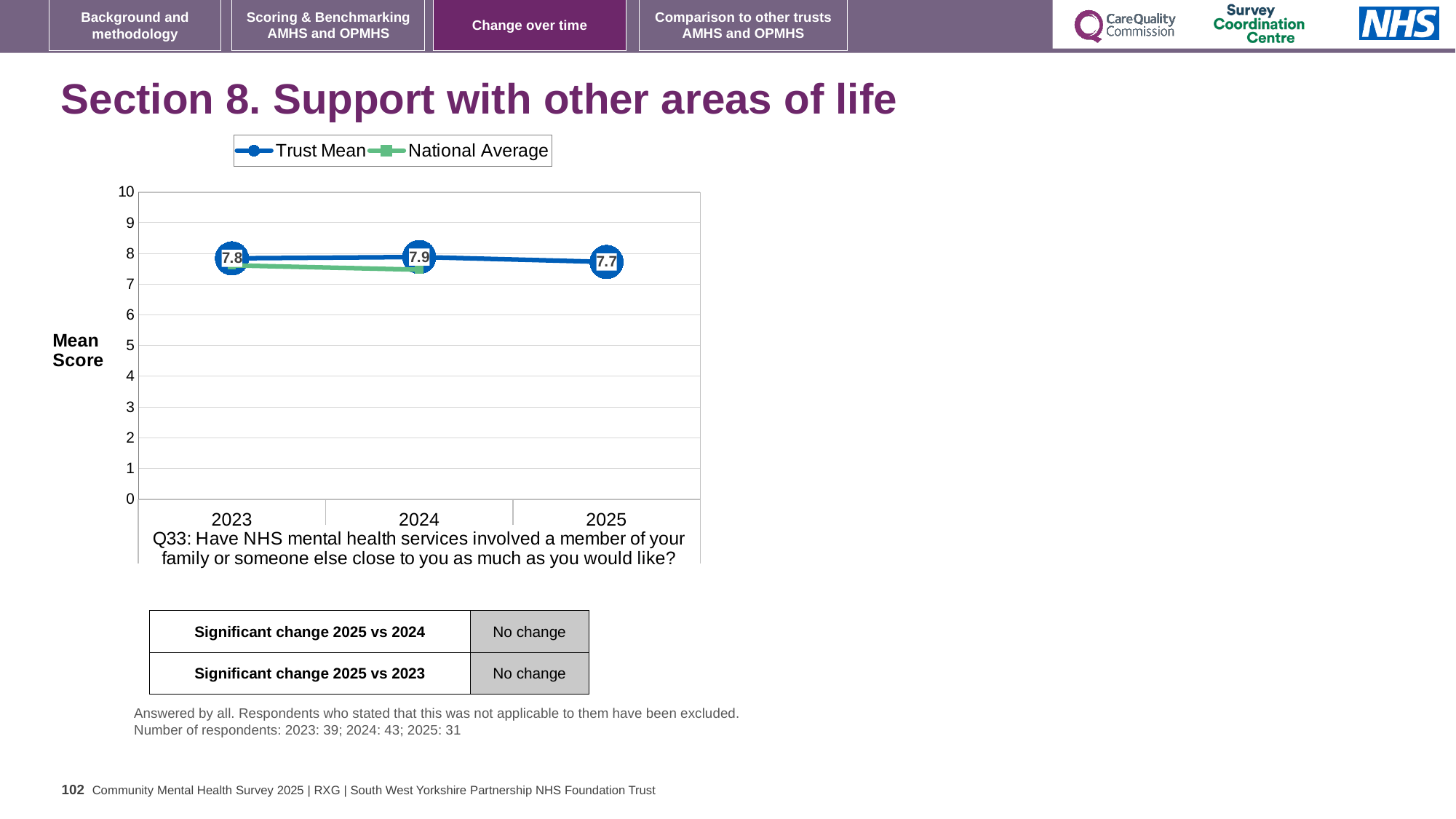
In which year is the Trust Mean lowest? 2025 What is the Trust Mean value for 2025? 7.7 What is the label of the y axis of the chart? Mean Score In which year is the Trust Mean highest? 2024 What is the difference between the Trust Mean in 2024 and in 2025? 0.2 Which is larger, the Trust Mean for 2023 or for 2025? 2023 What is the Trust Mean value for 2023? 7.8 What is the Trust Mean value for 2024? 7.9 Is the Trust Mean for 2025 greater or less than 5? greater What kind of chart is shown on the slide? Line chart How many years are shown on the x axis of the chart? 3 How many series does the chart legend list? 2